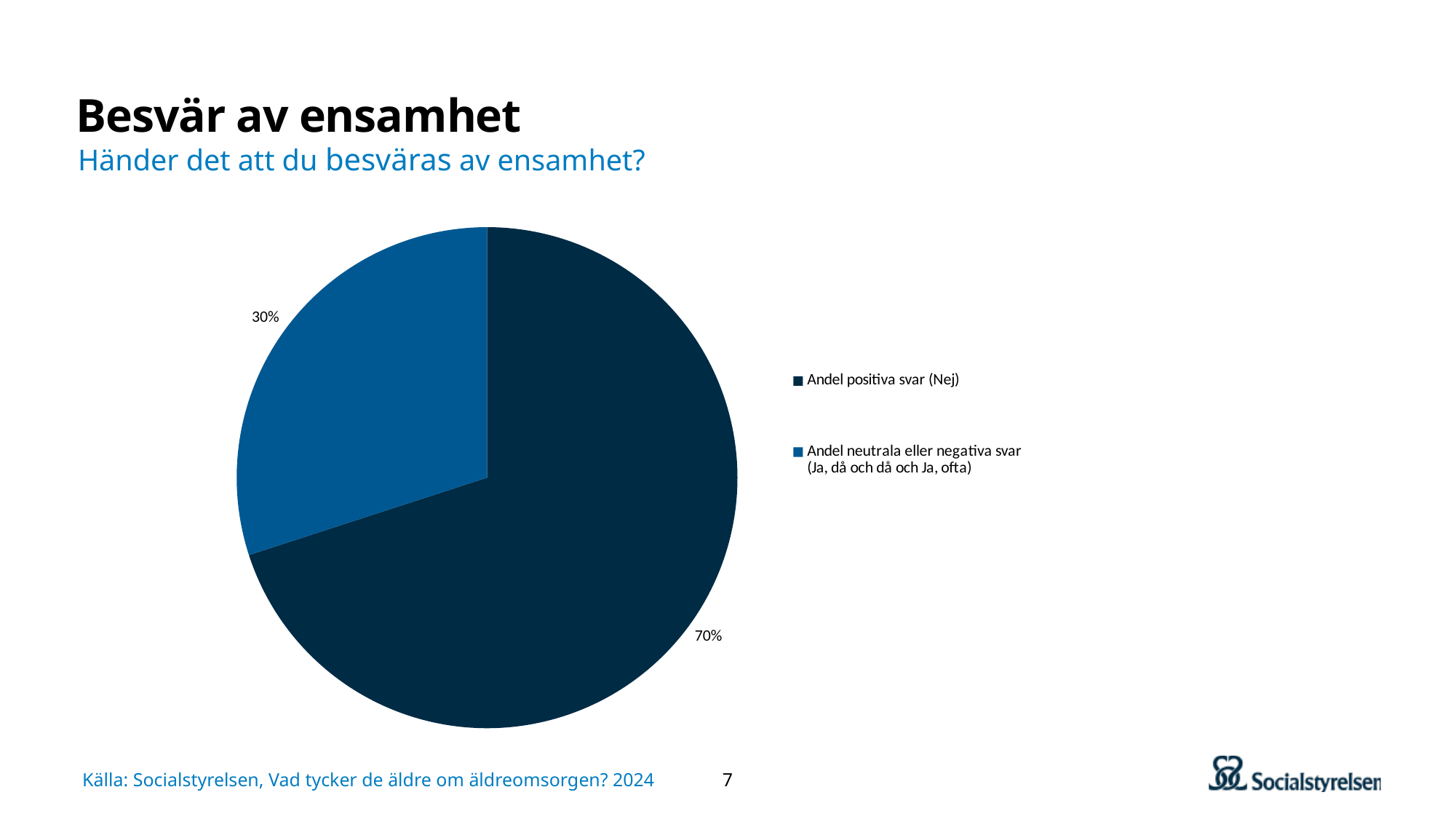
Which legend entry is shown in the lighter blue colour? Andel neutrala eller negativa svar (Ja, då och då och Ja, ofta) What is the difference in percentage points between the "Andel positiva svar (Nej)" slice and the "Andel neutrala eller negativa svar" slice? 40 percentage points What share of the pie is "Andel positiva svar (Nej)"? 70% Which is larger: the share for "Andel positiva svar (Nej)" or the share for "Andel neutrala eller negativa svar"? Andel positiva svar (Nej) What share of the pie is "Andel neutrala eller negativa svar (Ja, då och då och Ja, ofta)"? 30% What kind of chart is shown on the slide? pie chart Which slice is the largest in the pie chart? Andel positiva svar (Nej) What question is shown as the subtitle above the chart? Händer det att du besväras av ensamhet? How many slices does the pie chart have? 2 What is the total of the two slices shown in the pie chart? 100% How many entries does the legend list? 2 Which slice is the smallest in the pie chart? Andel neutrala eller negativa svar (Ja, då och då och Ja, ofta)